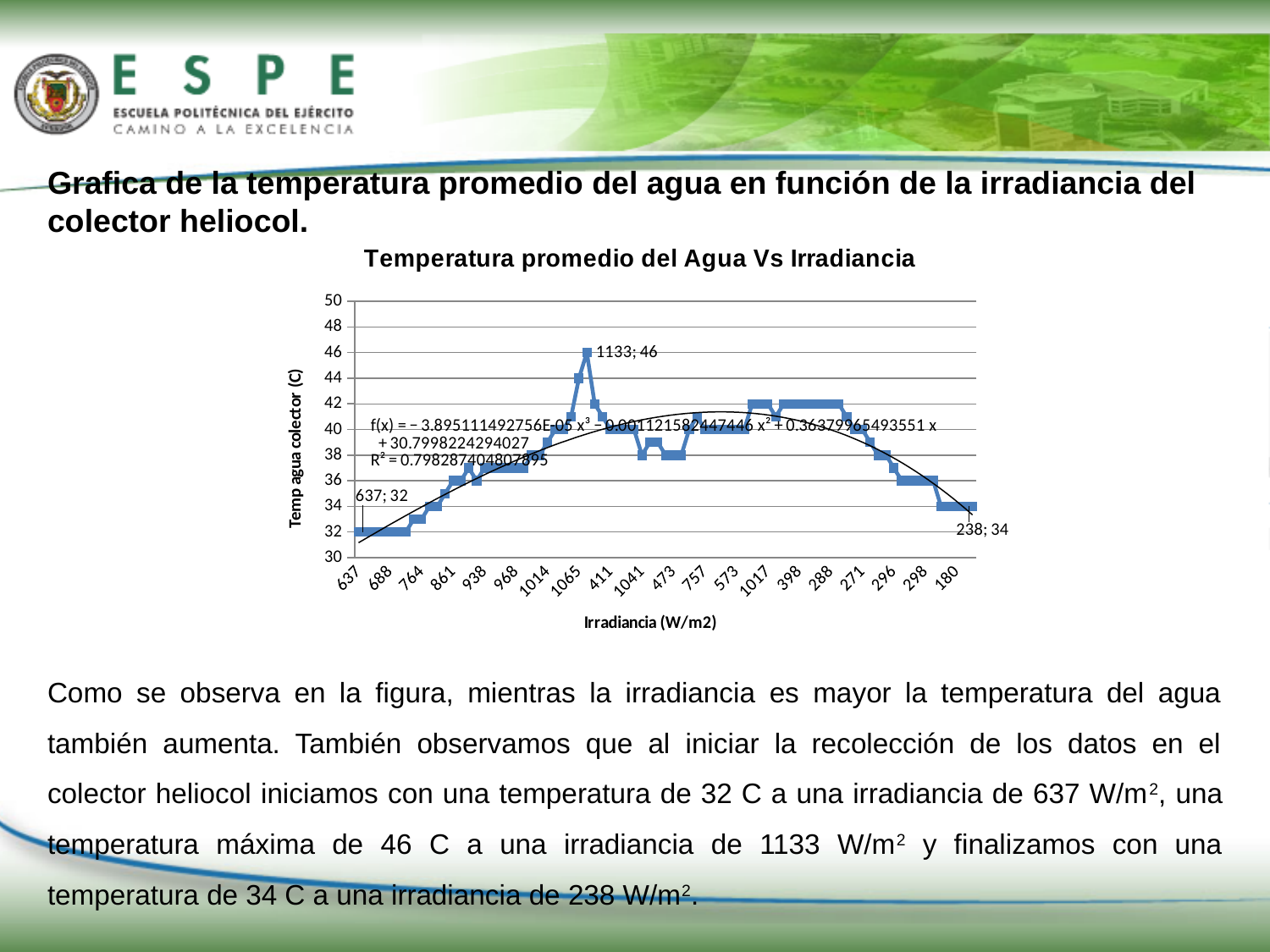
Does the water temperature rise or fall between the first point (637) and the labeled point at 1133? rise Which has the higher water temperature: the point at 637 W/m2 or the point at 238 W/m2? 238 W/m2 What is the chart's title? Temperatura promedio del Agua Vs Irradiancia What kind of chart is shown on the slide? line chart What R² value is printed for the trendline on the chart? 0.798287404807895 What is the difference between the temperature at 1133 W/m2 and the temperature at 238 W/m2? 12 What is the water temperature at an irradiance of 238 W/m2? 34 At which irradiance value does the water temperature reach its maximum? 1133 What is the water temperature at an irradiance of 1133 W/m2? 46 What is the difference between the temperature at 1133 W/m2 and the temperature at 637 W/m2? 14 What is the water temperature at an irradiance of 637 W/m2? 32